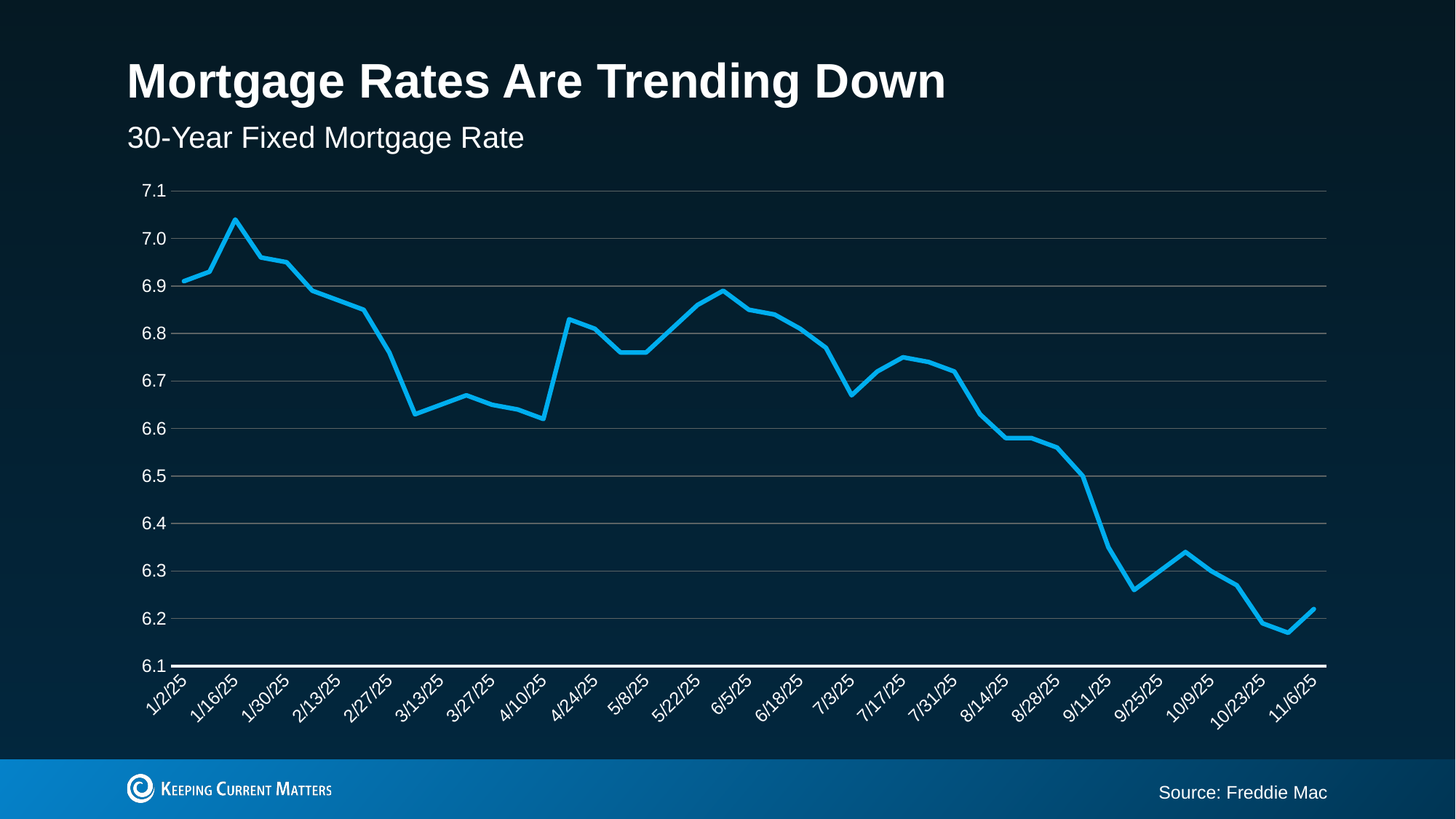
Which has the higher mortgage rate, 1/2/25 or 11/6/25? 1/2/25 What is the title of the chart on the slide? Mortgage Rates Are Trending Down What is the source cited for the chart data? Freddie Mac How many dates are labeled on the x axis? 23 Overall, do the mortgage rate values rise or fall from 1/2/25 to 11/6/25? Fall Is the value for 1/16/25 greater or less than 7.0? greater Is the value for 3/13/25 greater or less than 6.7? less Is the value for 11/6/25 greater or less than 6.3? less What kind of chart is shown on the slide? Line chart Which labeled date has the highest 30-year fixed mortgage rate? 1/16/25